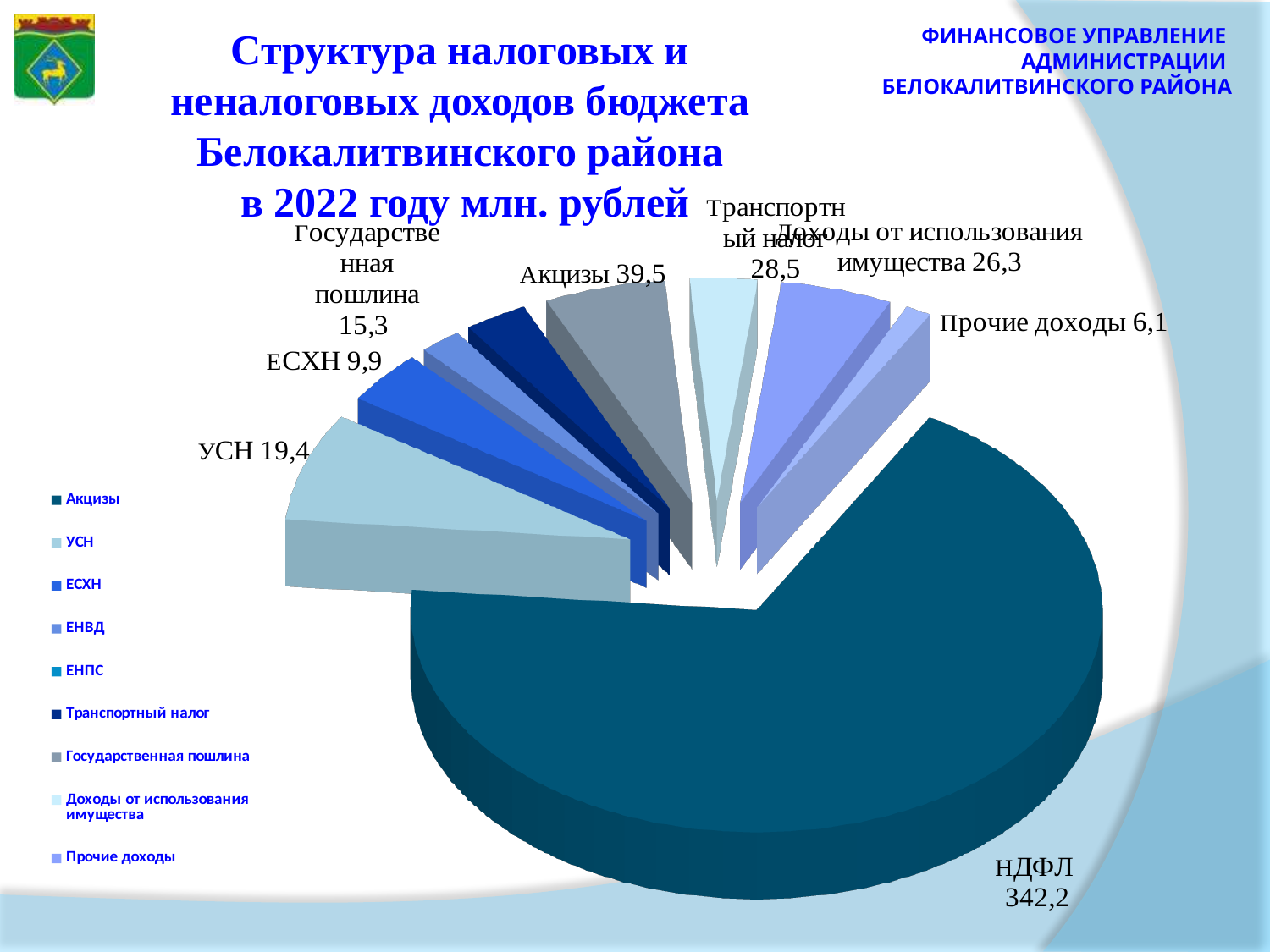
What kind of chart is shown on the slide? Pie chart What is the difference between the values for УСН and ЕСХН? 9,5 What is the difference between the values for Акцизы and Транспортный налог? 11,0 Which category has the largest slice of the pie chart? НДФЛ What value is shown for Акцизы on the pie chart? 39,5 What value is shown for НДФЛ on the pie chart? 342,2 Which labelled category has the smallest value on the pie chart? Прочие доходы Which is larger, the value for Транспортный налог or the value for Доходы от использования имущества? Транспортный налог What value is shown for Доходы от использования имущества on the pie chart? 26,3 What value is shown for Государственная пошлина on the pie chart? 15,3 What value is shown for Транспортный налог on the pie chart? 28,5 How many entries does the legend of the chart list? 9